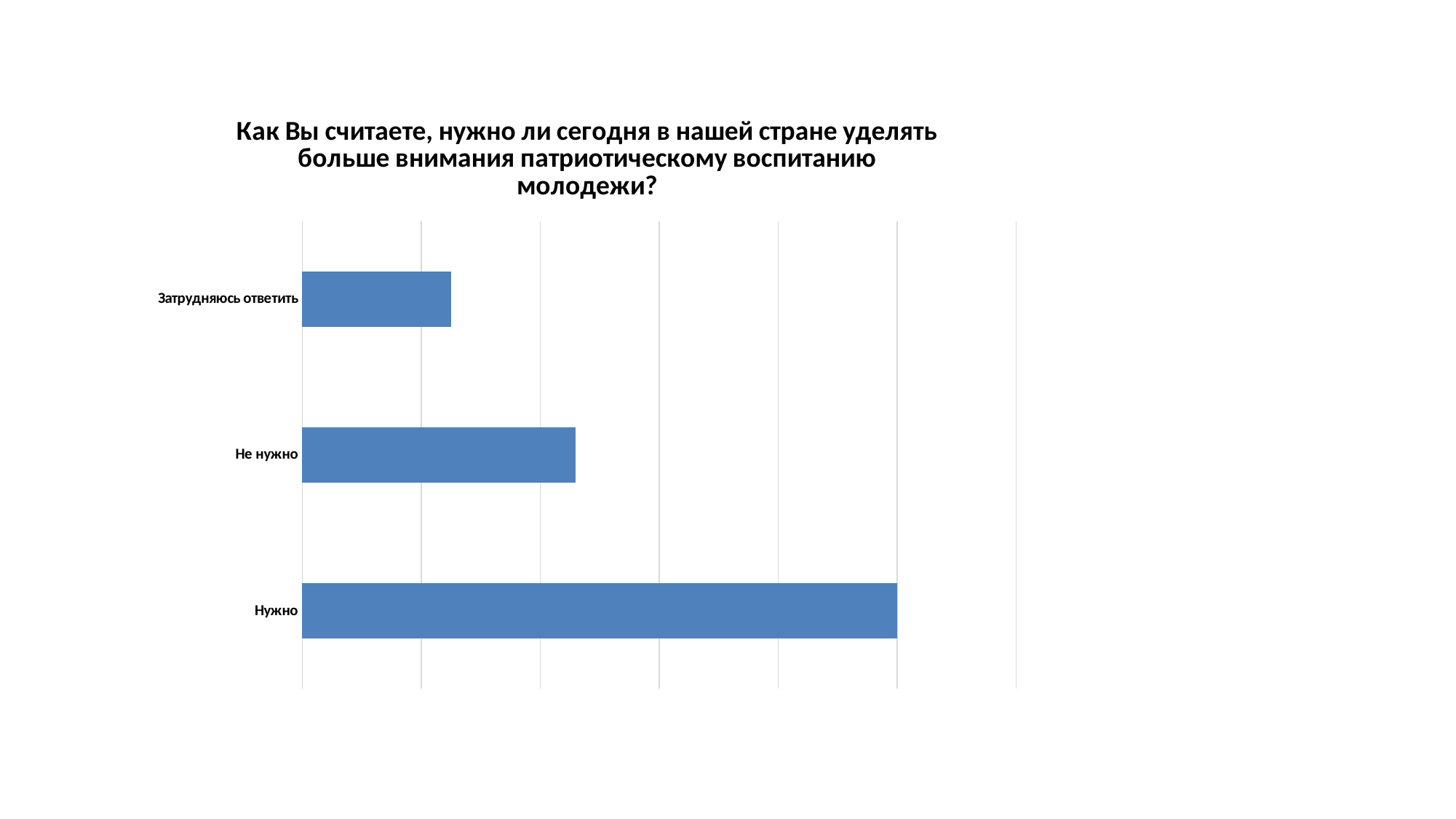
Which category has the lowest value? Затрудняюсь ответить What colour are the bars in the chart? Blue Which is larger, the value for Нужно or the value for Не нужно? Нужно Which category has the highest value? Нужно What kind of chart is shown on the slide? Bar chart How many categories are shown in the chart? 3 Which is larger, the value for Не нужно or the value for Затрудняюсь ответить? Не нужно What is the title of the chart? Как Вы считаете, нужно ли сегодня в нашей стране уделять больше внимания патриотическому воспитанию молодежи?